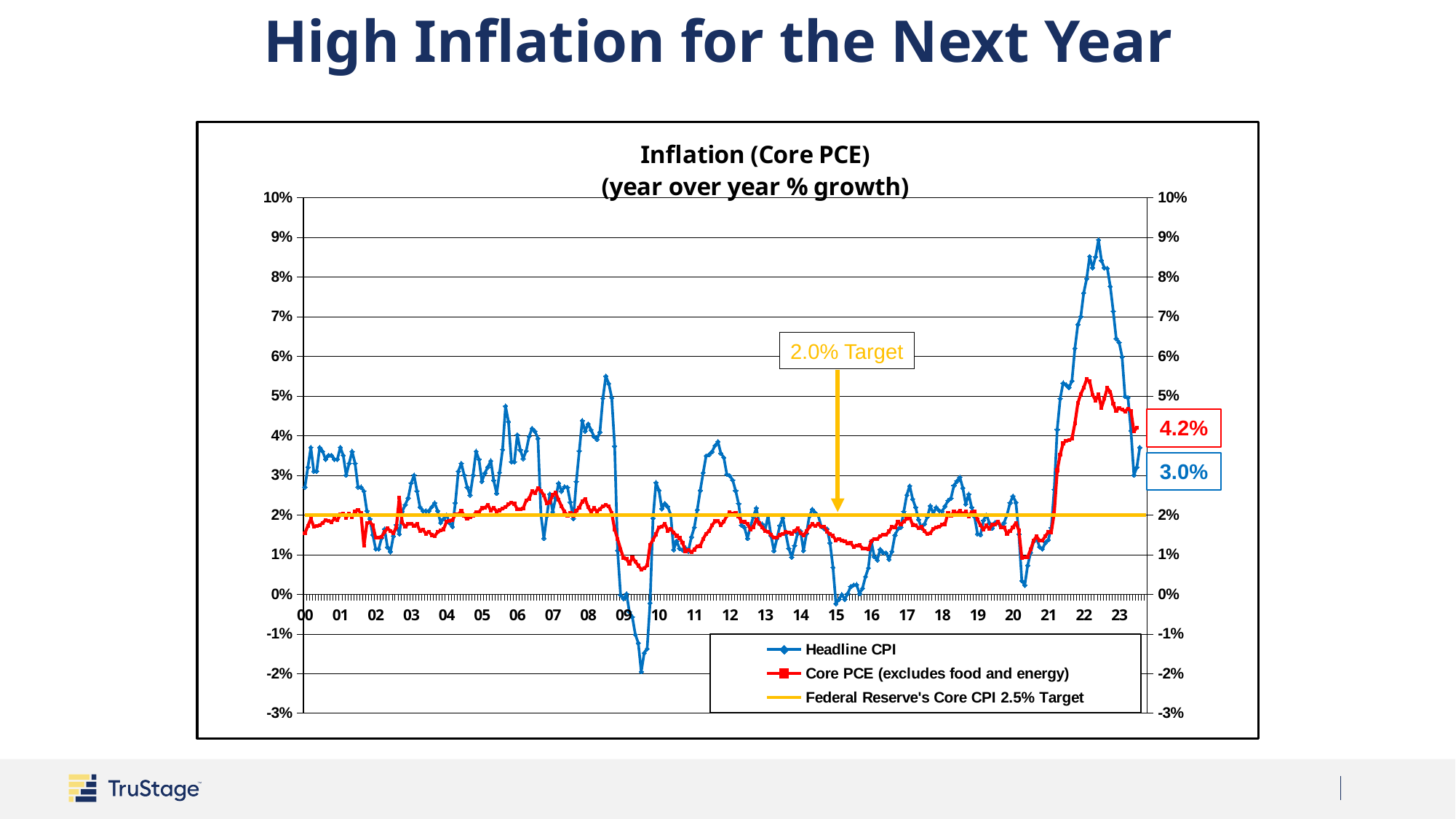
How many series does the legend list? 3 What is the latest labelled value for Headline CPI? 3.0% What is the legend label for the yellow line? Federal Reserve's Core CPI 2.5% Target What kind of chart is shown on the slide? Line chart What value does the annotated target line sit at? 2.0% Which is larger at the end of the chart, the labelled Core PCE value or the labelled Headline CPI value? Core PCE (4.2%) Does Headline CPI rise or fall from its 2022 peak to the end of 2023? Fall Is the lowest value of Headline CPI around 2009 greater or less than -1%? less What is the latest labelled value for Core PCE? 4.2% Is the peak value of Headline CPI in 2022 greater or less than 8%? greater Which series reaches the highest value anywhere on the chart? Headline CPI What is the difference between the latest labelled Core PCE value (4.2%) and the latest labelled Headline CPI value (3.0%)? 1.2 percentage points